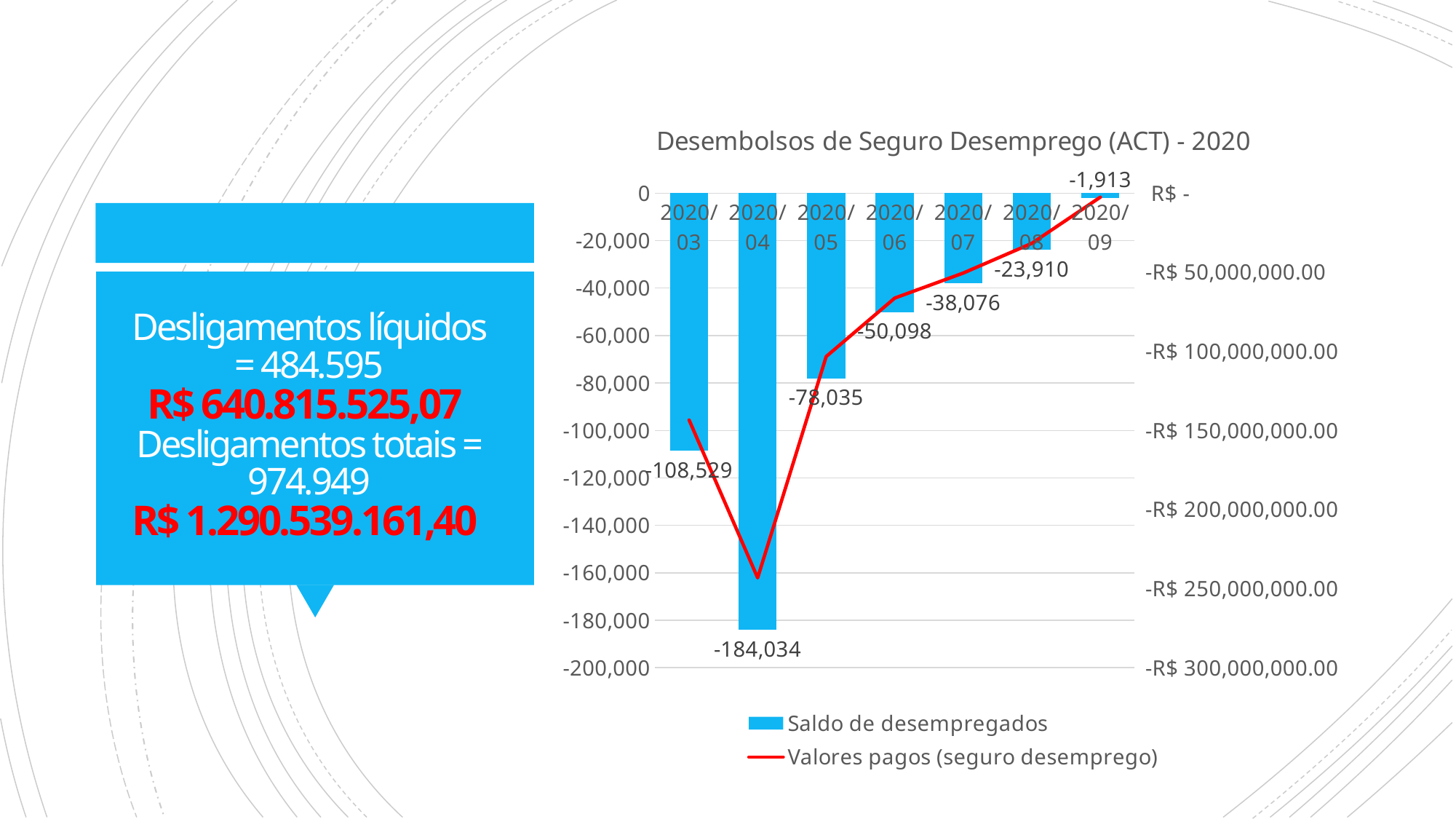
What is the Saldo de desempregados value for 2020/04? -184,034 What is the Saldo de desempregados value for 2020/09? -1,913 Which month has the lowest (most negative) Saldo de desempregados? 2020/04 What is the Saldo de desempregados value for 2020/05? -78,035 What is the Saldo de desempregados value for 2020/07? -38,076 How many months are shown on the x axis? 7 Which bar is longer (more negative): 2020/03 or 2020/05? 2020/03 Which month has the Saldo de desempregados closest to zero? 2020/09 What is the difference between the Saldo de desempregados values for 2020/06 and 2020/08? 26,188 How many series does the legend list? 2 What is the title of the chart? Desembolsos de Seguro Desemprego (ACT) - 2020 Is the Valores pagos (seguro desemprego) value for 2020/04 greater or less than -R$ 200,000,000.00? less